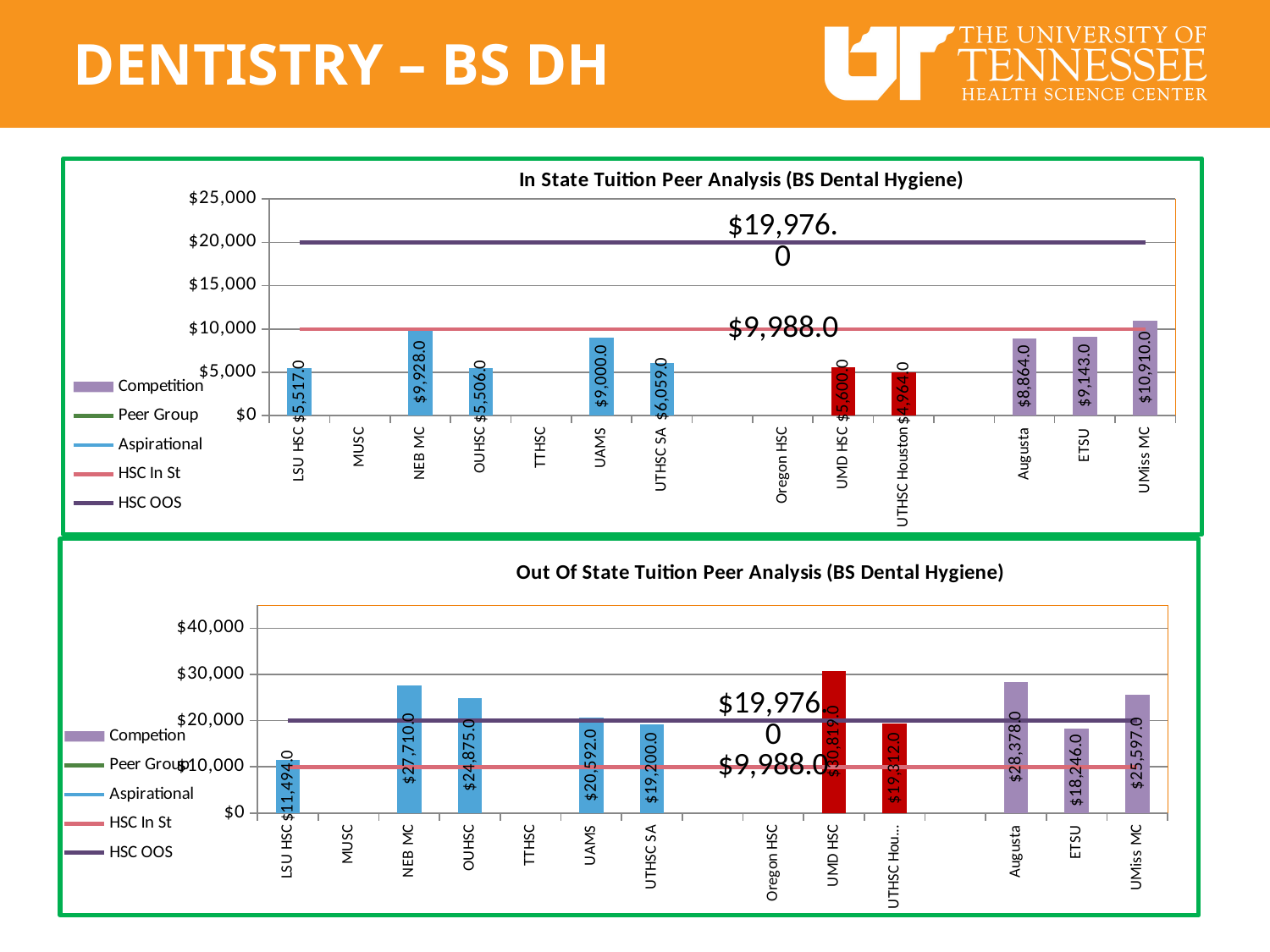
In the In State Tuition Peer Analysis chart, which institution has the lowest bar? UTHSC Houston In the Out Of State Tuition Peer Analysis chart, what is the value for Augusta? $28,378.0 In the Out Of State Tuition Peer Analysis chart, is the value for ETSU greater or less than $20,000? less In the Out Of State Tuition Peer Analysis chart, which institution has the lowest bar? LSU HSC In the In State Tuition Peer Analysis chart, what is the value for NEB MC? $9,928.0 In the In State Tuition Peer Analysis chart, which institution has the highest bar? UMiss MC In the In State Tuition Peer Analysis chart, what value is labelled on the HSC OOS line? $19,976.0 In the Out Of State Tuition Peer Analysis chart, which institution has the highest bar? UMD HSC How many series does the legend of the In State Tuition Peer Analysis chart list? 5 In the Out Of State Tuition Peer Analysis chart, what is the difference between the values for NEB MC and OUHSC? $2,835.0 In the In State Tuition Peer Analysis chart, which is larger, the value for UAMS or the value for ETSU? ETSU What kind of chart is the Out Of State Tuition Peer Analysis chart? bar chart